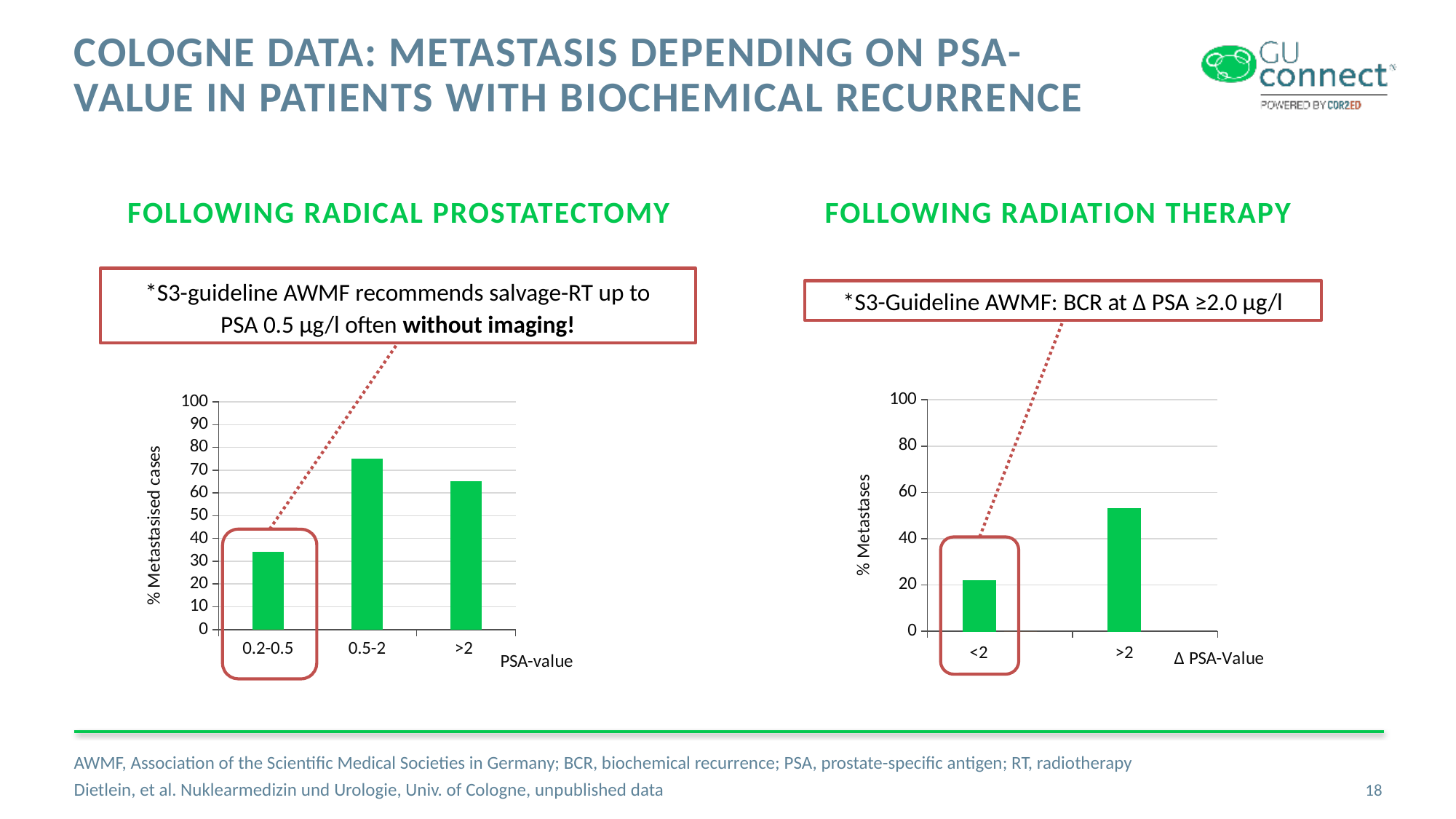
In the 'Following radical prostatectomy' chart, which PSA-value category has the highest percentage of metastasised cases? 0.5-2 What is the y-axis label of the 'Following radiation therapy' chart? % Metastases In the 'Following radical prostatectomy' chart, is the value for PSA 0.5-2 greater or less than 70? greater In the 'Following radiation therapy' chart, is the value for Δ PSA <2 greater or less than 40? less In the 'Following radiation therapy' chart, how many Δ PSA-value categories are shown? 2 In the 'Following radical prostatectomy' chart, how many PSA-value categories are shown? 3 In the 'Following radiation therapy' chart, which Δ PSA-value category has the higher percentage of metastases? >2 In the 'Following radical prostatectomy' chart, which PSA-value category has the lowest percentage of metastasised cases? 0.2-0.5 What kind of chart is the 'Following radical prostatectomy' chart? bar chart In the 'Following radical prostatectomy' chart, which is larger: the value for PSA 0.5-2 or the value for PSA >2? 0.5-2 In the 'Following radical prostatectomy' chart, is the value for PSA 0.2-0.5 greater or less than 40? less